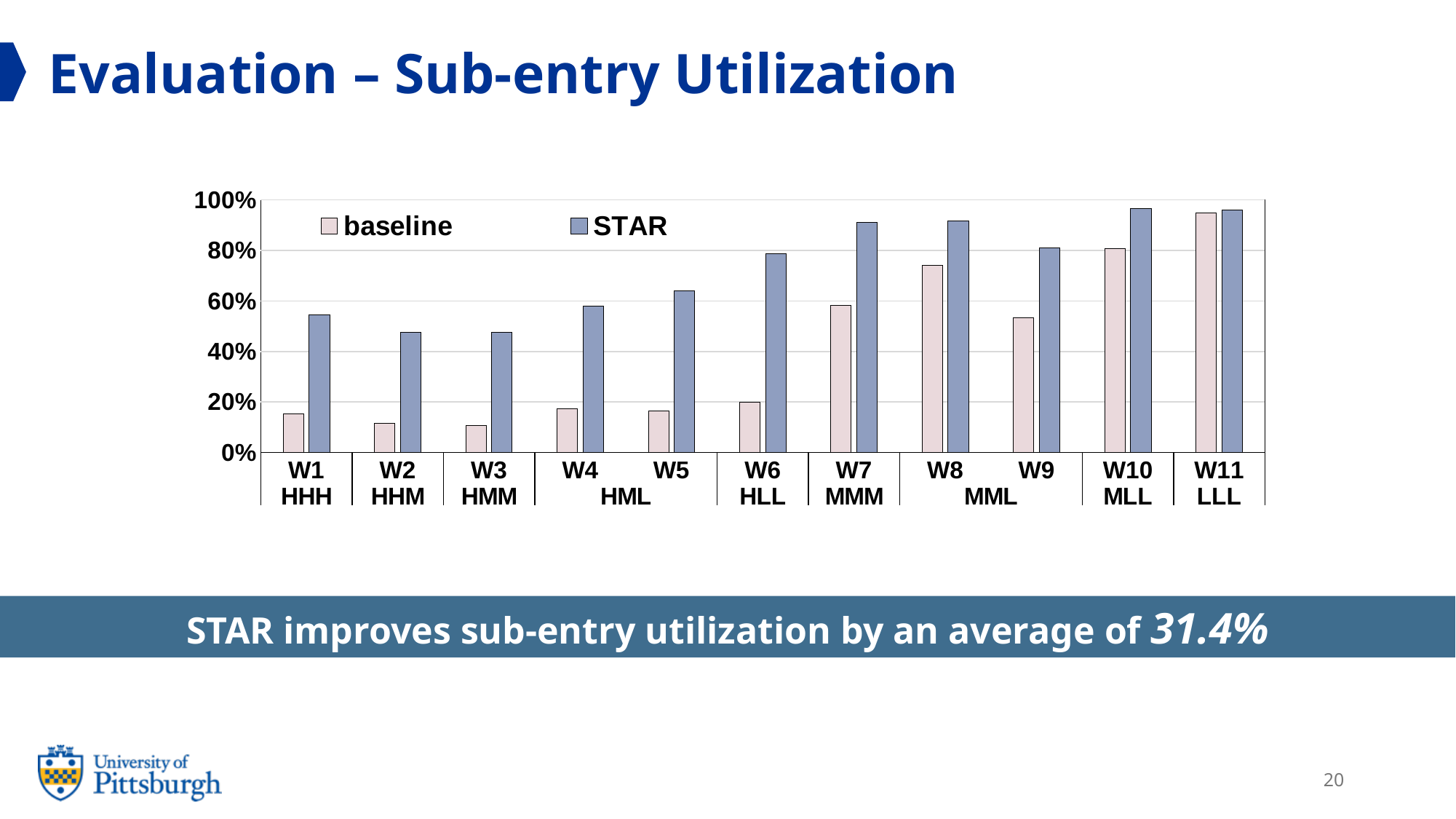
Is the baseline value for W8 greater or less than 60%? greater What are the two series named in the legend? baseline and STAR How many series does the chart's legend list? 2 How many workloads (W1 to W11) are plotted on the x axis? 11 Which has the larger baseline value, W8 or W9? W8 According to the slide's summary banner, by what average does STAR improve sub-entry utilization? 31.4% Is the STAR value for W7 greater or less than 80%? greater Is the STAR value for W2 greater or less than 60%? less What kind of chart is shown on the slide? bar chart Which workload has the highest baseline sub-entry utilization? W11 For W7, which series has the larger value, baseline or STAR? STAR